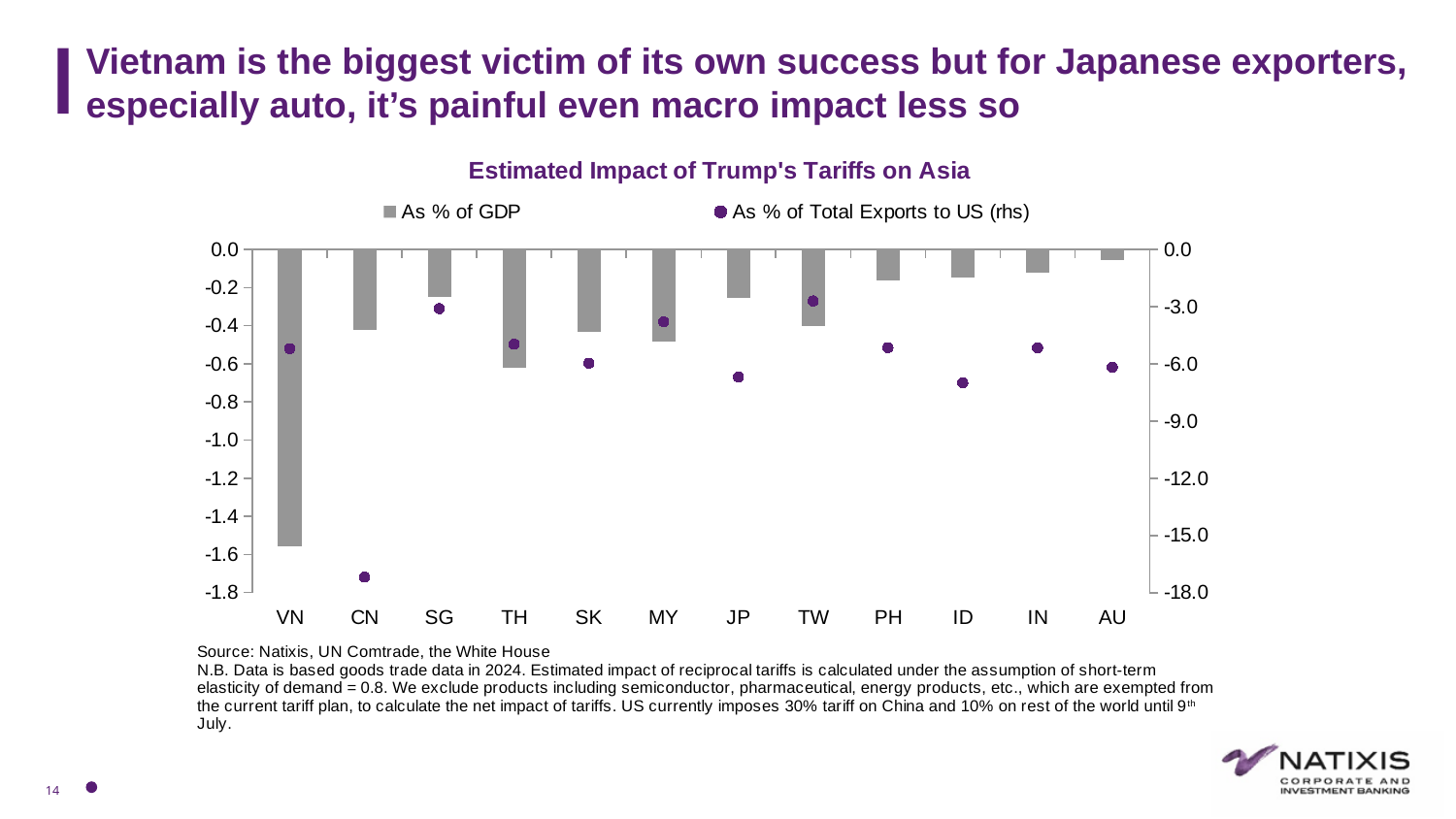
Is the 'As % of Total Exports to US (rhs)' value for CN greater or less than -15.0? less What is the title of the chart? Estimated Impact of Trump's Tariffs on Asia Is the 'As % of GDP' value for TH greater or less than -0.4? less Which country has the lowest (most negative) value for 'As % of Total Exports to US (rhs)'? CN Which series is plotted on the right-hand axis? As % of Total Exports to US (rhs) Which country has the highest (closest to zero) value for 'As % of GDP'? AU How many countries are shown on the x axis of the chart? 12 Which country has the lower 'As % of GDP' value, VN or CN? VN Is the 'As % of GDP' value for VN greater or less than -1.0? less What kind of chart is used to plot the 'As % of GDP' series? bar chart Which country has the lowest (most negative) value for 'As % of GDP'? VN How many series does the chart legend list? 2